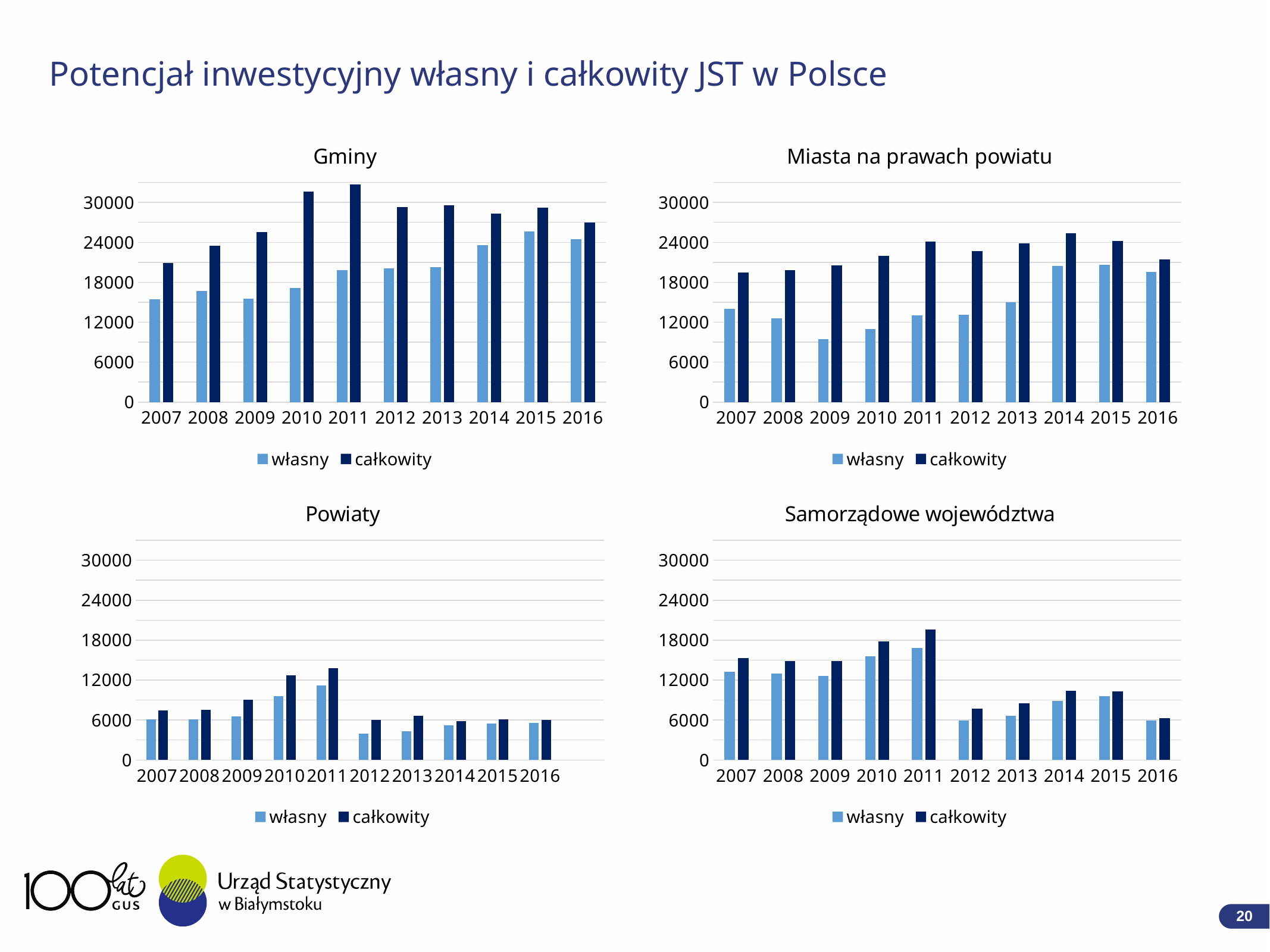
In the Miasta na prawach powiatu chart, which year has the lowest własny value? 2009 How many years are shown on the x axis of the Gminy chart? 10 In the Gminy chart, which year has the highest całkowity value? 2011 In the Gminy chart, which year has the highest własny value? 2015 In the Samorządowe województwa chart, is the całkowity value for 2011 greater or less than 18000? greater How many series does the legend of the Powiaty chart list? 2 In the Samorządowe województwa chart, which is larger, the własny value for 2011 or the własny value for 2012? 2011 In the Gminy chart, is the całkowity value for 2011 greater or less than 30000? greater In the Miasta na prawach powiatu chart, which year has the highest całkowity value? 2014 In the Powiaty chart, which year has the lowest własny value? 2012 In the Miasta na prawach powiatu chart, is the własny value for 2009 greater or less than 12000? less